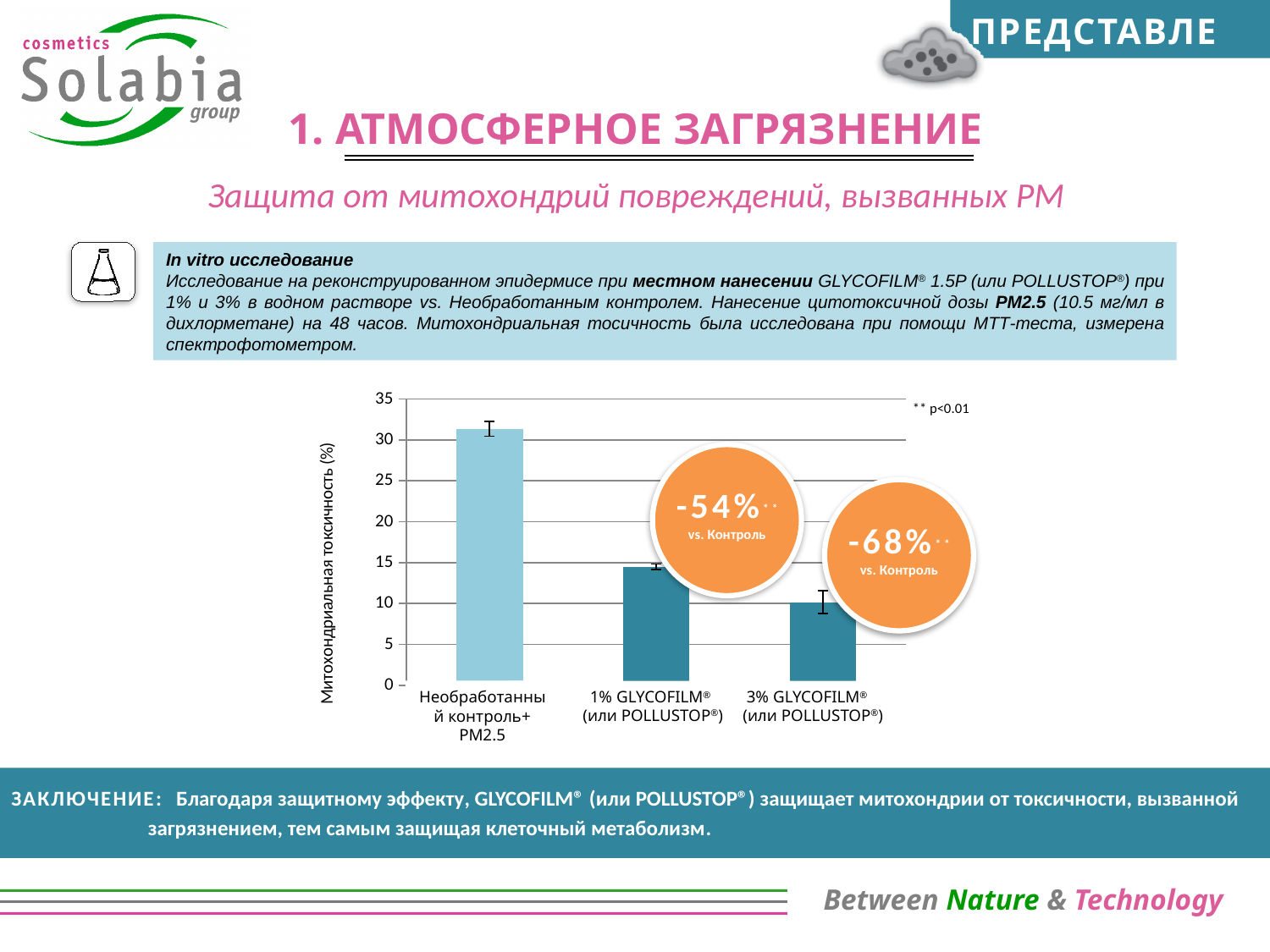
What percentage reduction vs. control is shown for 1% GLYCOFILM® (или POLLUSTOP®)? -54% What percentage reduction vs. control is shown for 3% GLYCOFILM® (или POLLUSTOP®)? -68% What is the label of the vertical axis of the chart? Митохондриальная токсичность (%) Which is larger: the value for 1% GLYCOFILM® or for 3% GLYCOFILM®? 1% GLYCOFILM® Is the value for 3% GLYCOFILM® (или POLLUSTOP®) greater or less than 15? less Which category has the lowest mitochondrial toxicity? 3% GLYCOFILM® (или POLLUSTOP®) How many bars (categories) are plotted in the chart? 3 Is the value for Необработанный контроль+ PM2.5 greater or less than 30? greater Which category has the highest mitochondrial toxicity? Необработанный контроль+ PM2.5 Is the value for 1% GLYCOFILM® (или POLLUSTOP®) greater or less than 20? less Do the bar values rise or fall from left to right across the categories? fall What kind of chart is shown on the slide? Bar chart